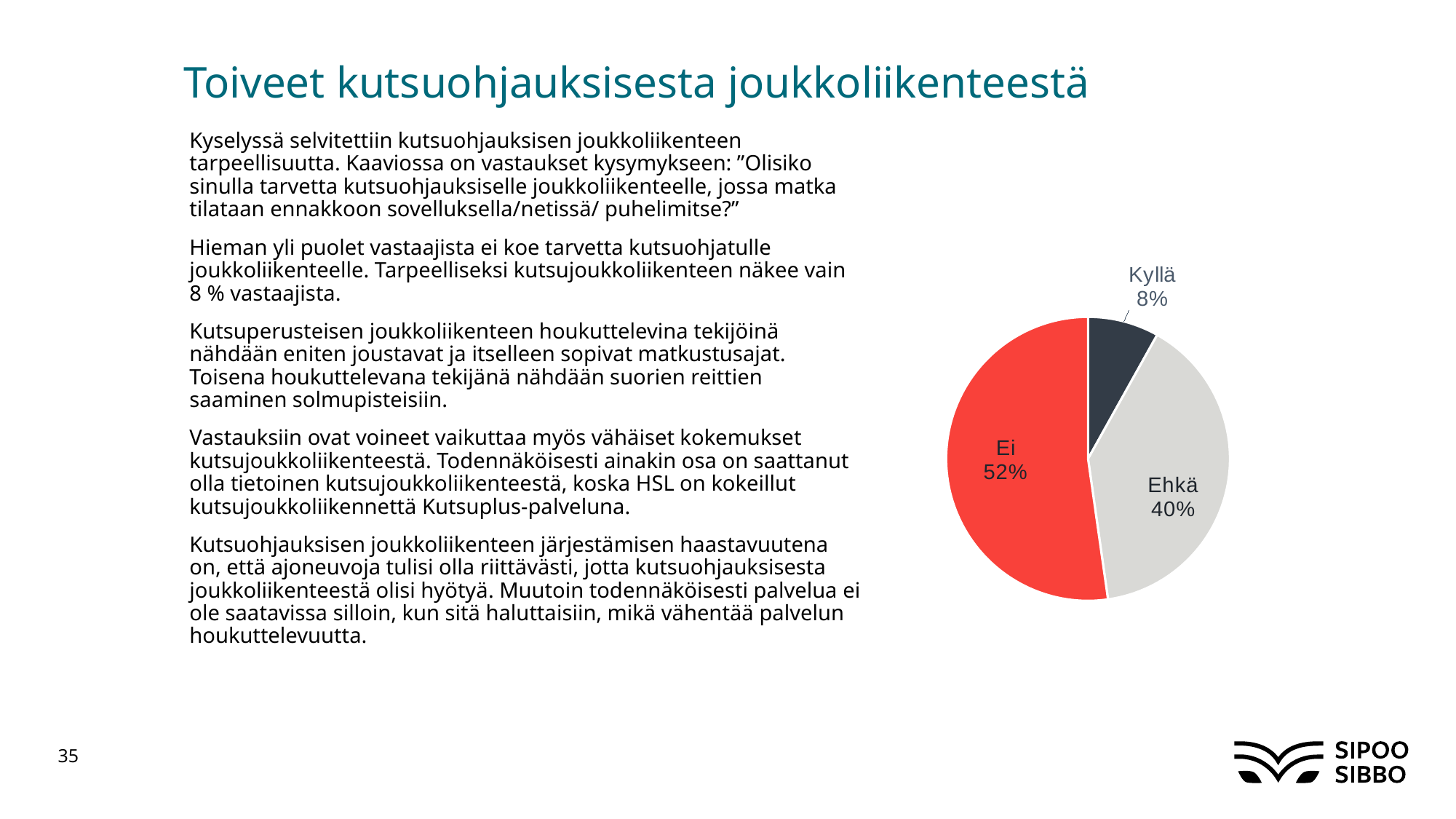
What kind of chart is shown on the slide? pie chart Which slice is larger, "Ehkä" or "Kyllä"? Ehkä How many slices does the pie chart have? 3 What is the difference in percentage points between the "Ei" and "Ehkä" slices? 12 What share of the pie does the "Ehkä" slice represent? 40% Is the share for "Ei" greater or less than 50%? greater What share of the pie does the "Kyllä" slice represent? 8% Which slice of the pie chart is the smallest? Kyllä What share of the pie does the "Ei" slice represent? 52% What colour is the "Ei" slice in the pie chart? red Which slice of the pie chart is the largest? Ei What is the difference in percentage points between the "Ehkä" and "Kyllä" slices? 32